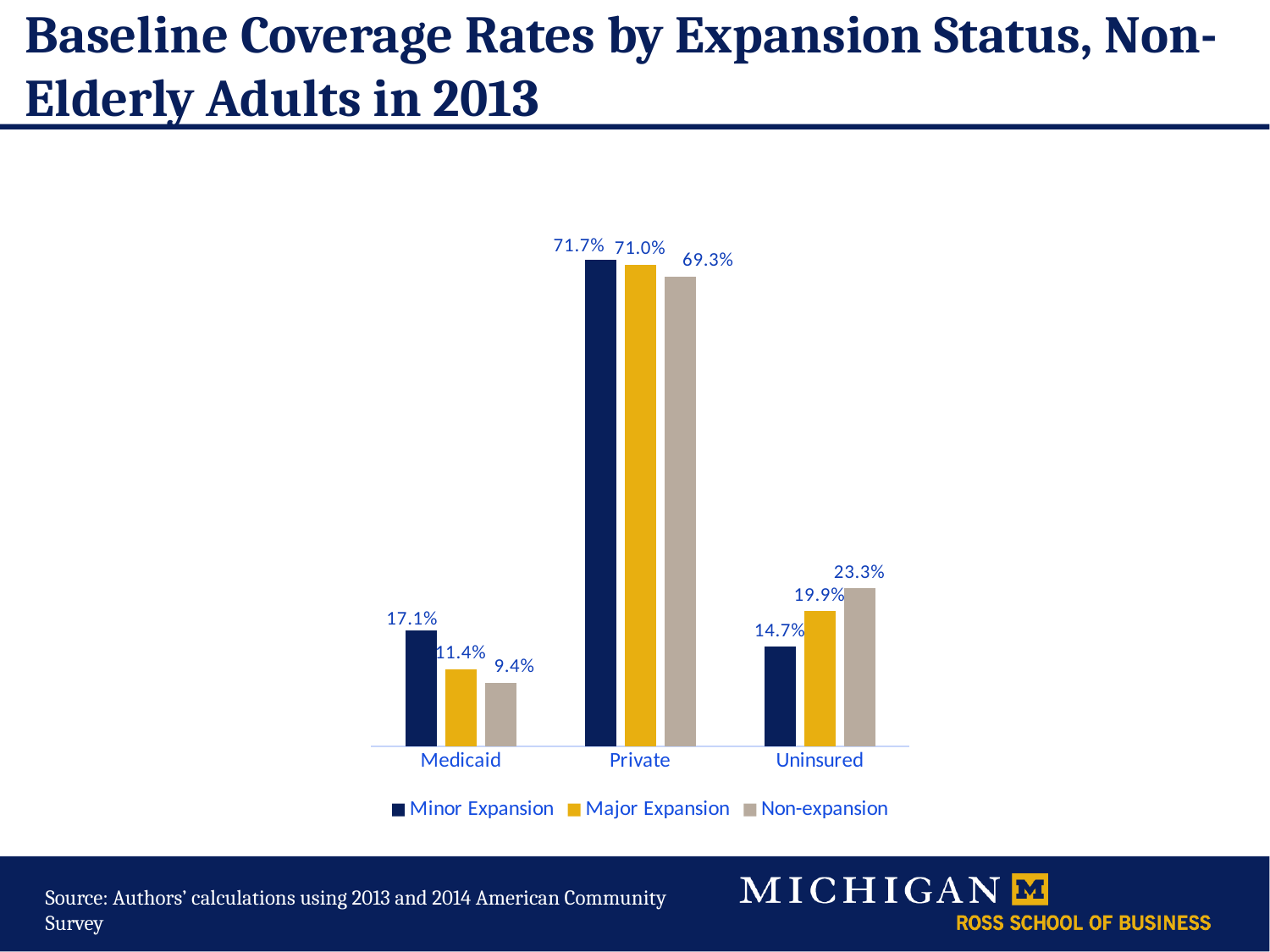
What kind of chart is shown on the slide? Bar chart What is the Private coverage rate for Non-expansion states? 69.3% What is the Uninsured rate for Major Expansion states? 19.9% How many series does the legend list? 3 Which is larger, the Private coverage rate for Minor Expansion or for Major Expansion states? Minor Expansion What is the difference between the Uninsured rates for Non-expansion and Minor Expansion states? 8.6% Which expansion status has the highest Uninsured rate? Non-expansion Which series is shown in yellow in the legend? Major Expansion Which expansion status has the lowest Medicaid coverage rate? Non-expansion How many coverage categories are shown on the x axis? 3 What is the Medicaid coverage rate for Minor Expansion states? 17.1% What is the difference between the Medicaid rates for Minor Expansion and Non-expansion states? 7.7%